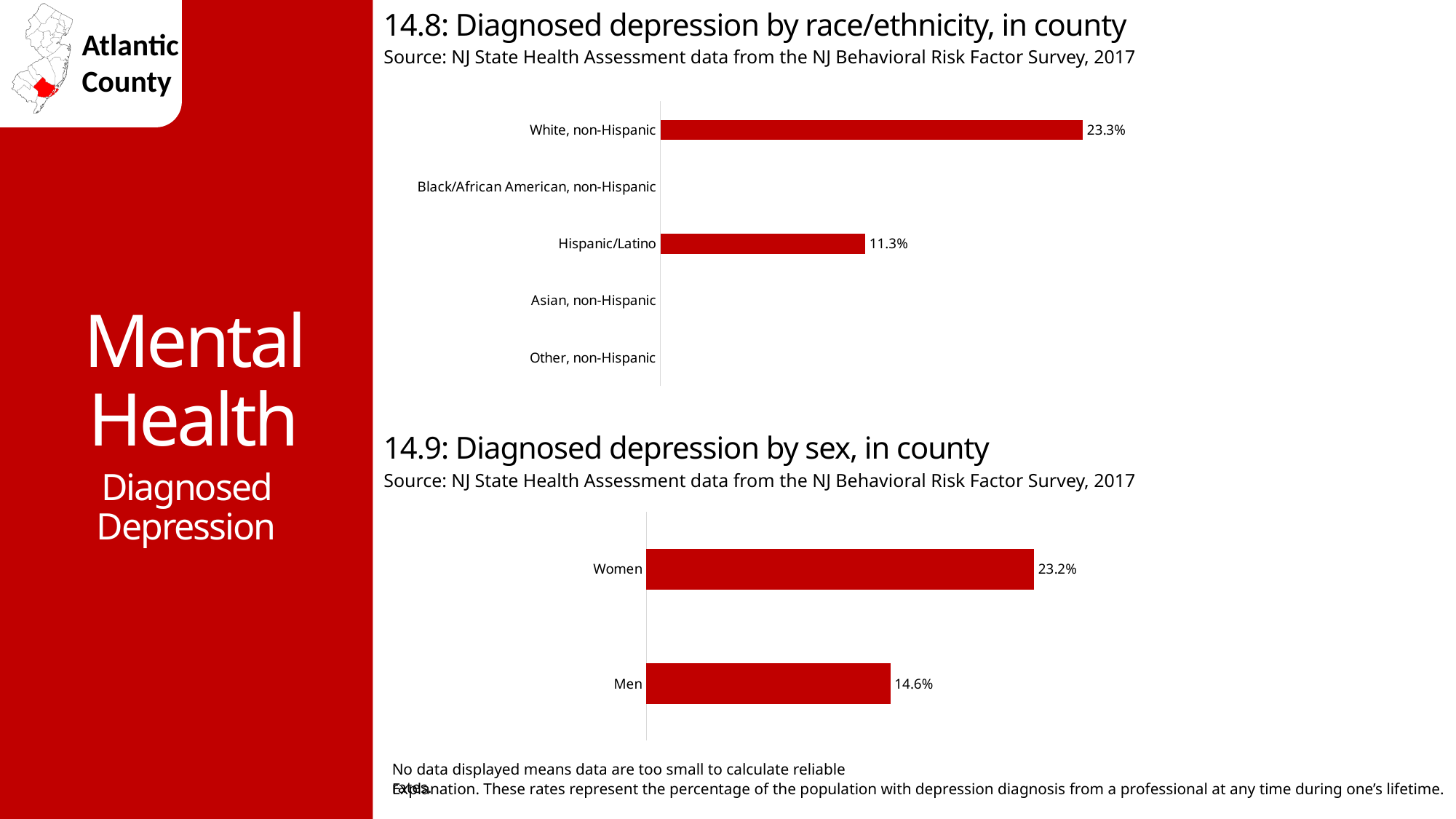
In the chart '14.8: Diagnosed depression by race/ethnicity, in county', which category has the highest value? White, non-Hispanic In the chart '14.9: Diagnosed depression by sex, in county', what is the difference between the Women and Men values? 8.6% What kind of chart is '14.8: Diagnosed depression by race/ethnicity, in county'? Bar chart In the chart '14.8: Diagnosed depression by race/ethnicity, in county', what is the value for Hispanic/Latino? 11.3% In the chart '14.8: Diagnosed depression by race/ethnicity, in county', how many categories are listed on the axis? 5 In the chart '14.9: Diagnosed depression by sex, in county', which category has the lowest value? Men In the chart '14.8: Diagnosed depression by race/ethnicity, in county', what is the difference between the White, non-Hispanic and Hispanic/Latino values? 12.0% In the chart '14.9: Diagnosed depression by sex, in county', what is the value for Women? 23.2% In the chart '14.8: Diagnosed depression by race/ethnicity, in county', what is the value for White, non-Hispanic? 23.3% In the chart '14.9: Diagnosed depression by sex, in county', which is larger, the value for Women or the value for Men? Women In the chart '14.8: Diagnosed depression by race/ethnicity, in county', how many categories have a bar displayed? 2 In the chart '14.9: Diagnosed depression by sex, in county', what is the value for Men? 14.6%